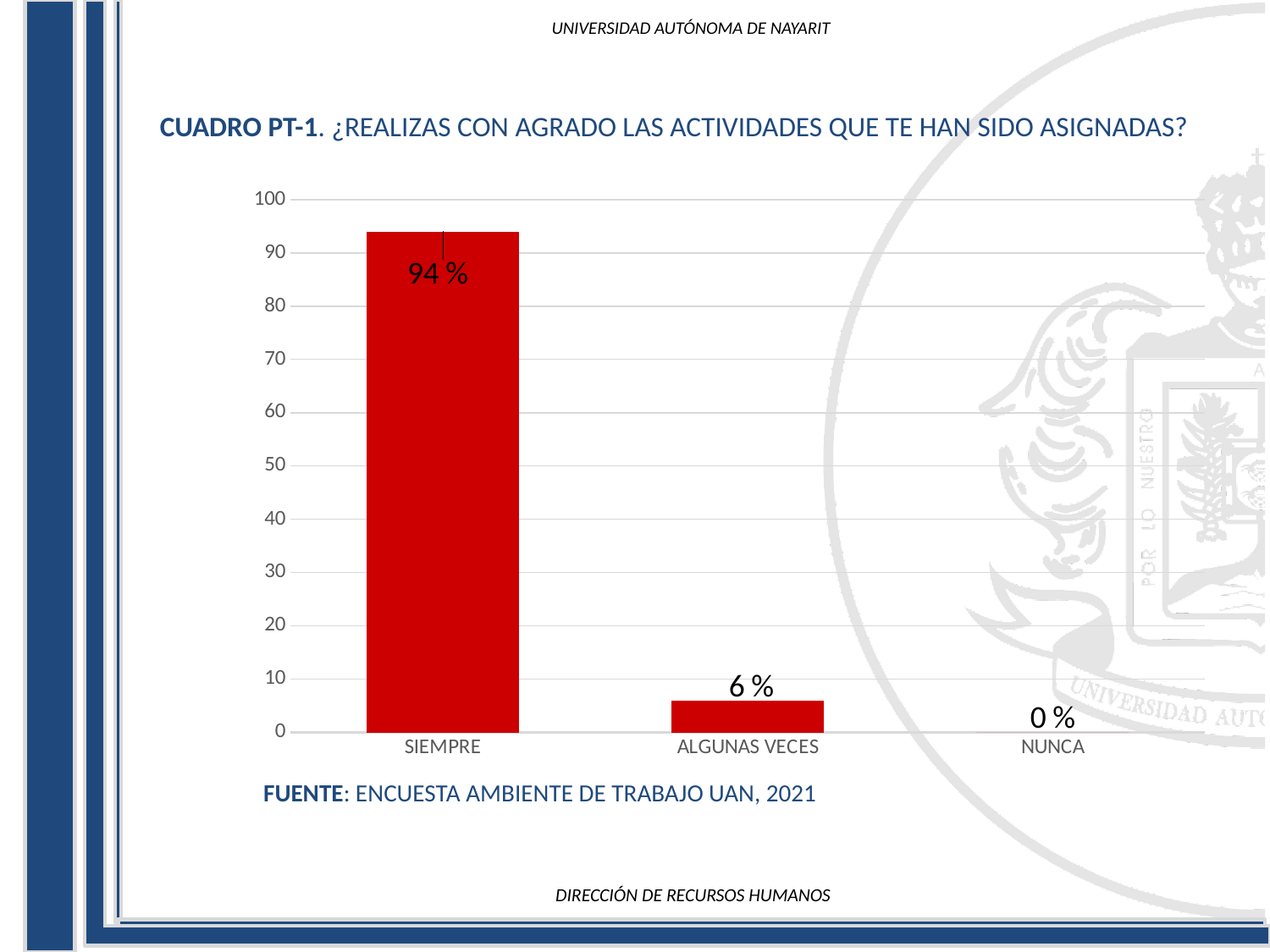
Which category has the highest value? SIEMPRE Is the value for SIEMPRE greater or less than 90? greater What is the value for SIEMPRE? 94 % Is the value for ALGUNAS VECES greater or less than 10? less What is the value for NUNCA? 0 % What is the difference between the values for SIEMPRE and ALGUNAS VECES? 88 % Which is larger, the value for ALGUNAS VECES or the value for NUNCA? ALGUNAS VECES What colour are the bars in the chart? red Which category has the lowest value? NUNCA What kind of chart is shown on the slide? bar chart How many categories are shown on the x axis? 3 What is the value for ALGUNAS VECES? 6 %